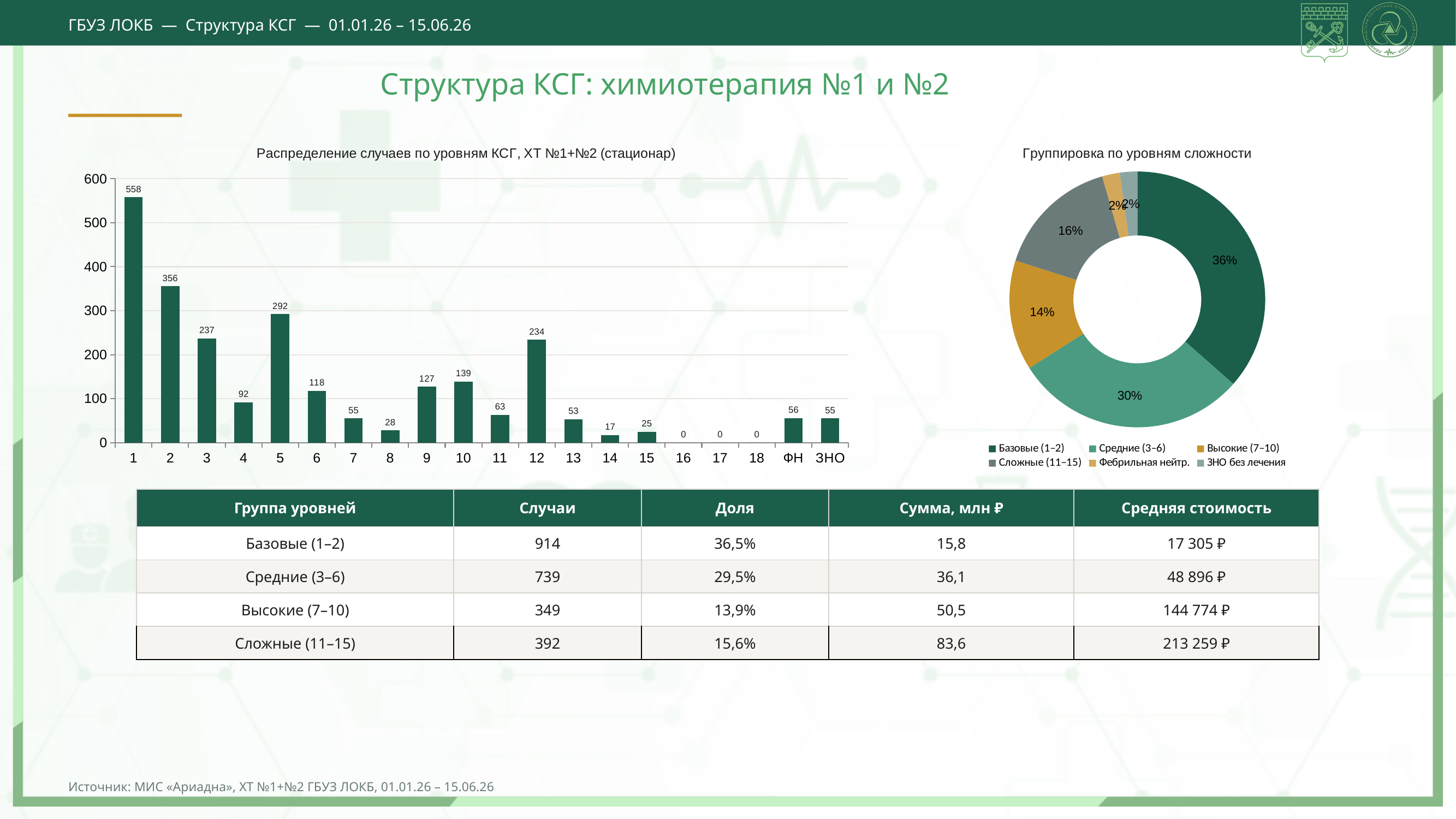
In the bar chart 'Распределение случаев по уровням КСГ, ХТ №1+№2 (стационар)', what is the difference between the values for level 2 and level 3? 119 How many entries does the legend of the chart 'Группировка по уровням сложности' list? 6 In the donut chart 'Группировка по уровням сложности', which slice is the largest? Базовые (1–2) In the bar chart 'Распределение случаев по уровням КСГ, ХТ №1+№2 (стационар)', what is the value for ФН? 56 In the bar chart 'Распределение случаев по уровням КСГ, ХТ №1+№2 (стационар)', which is larger, the value for level 5 or the value for level 12? level 5 In the bar chart 'Распределение случаев по уровням КСГ, ХТ №1+№2 (стационар)', how many categories are shown on the x axis? 20 In the donut chart 'Группировка по уровням сложности', what share is labelled for the 'Высокие (7–10)' slice? 14% In the donut chart 'Группировка по уровням сложности', what share is labelled for the 'Базовые (1–2)' slice? 36% In the bar chart 'Распределение случаев по уровням КСГ, ХТ №1+№2 (стационар)', what is the value for level 12? 234 In the bar chart 'Распределение случаев по уровням КСГ, ХТ №1+№2 (стационар)', what is the value for level 1? 558 What kind of chart is 'Распределение случаев по уровням КСГ, ХТ №1+№2 (стационар)'? bar chart In the bar chart 'Распределение случаев по уровням КСГ, ХТ №1+№2 (стационар)', which category has the highest value? 1